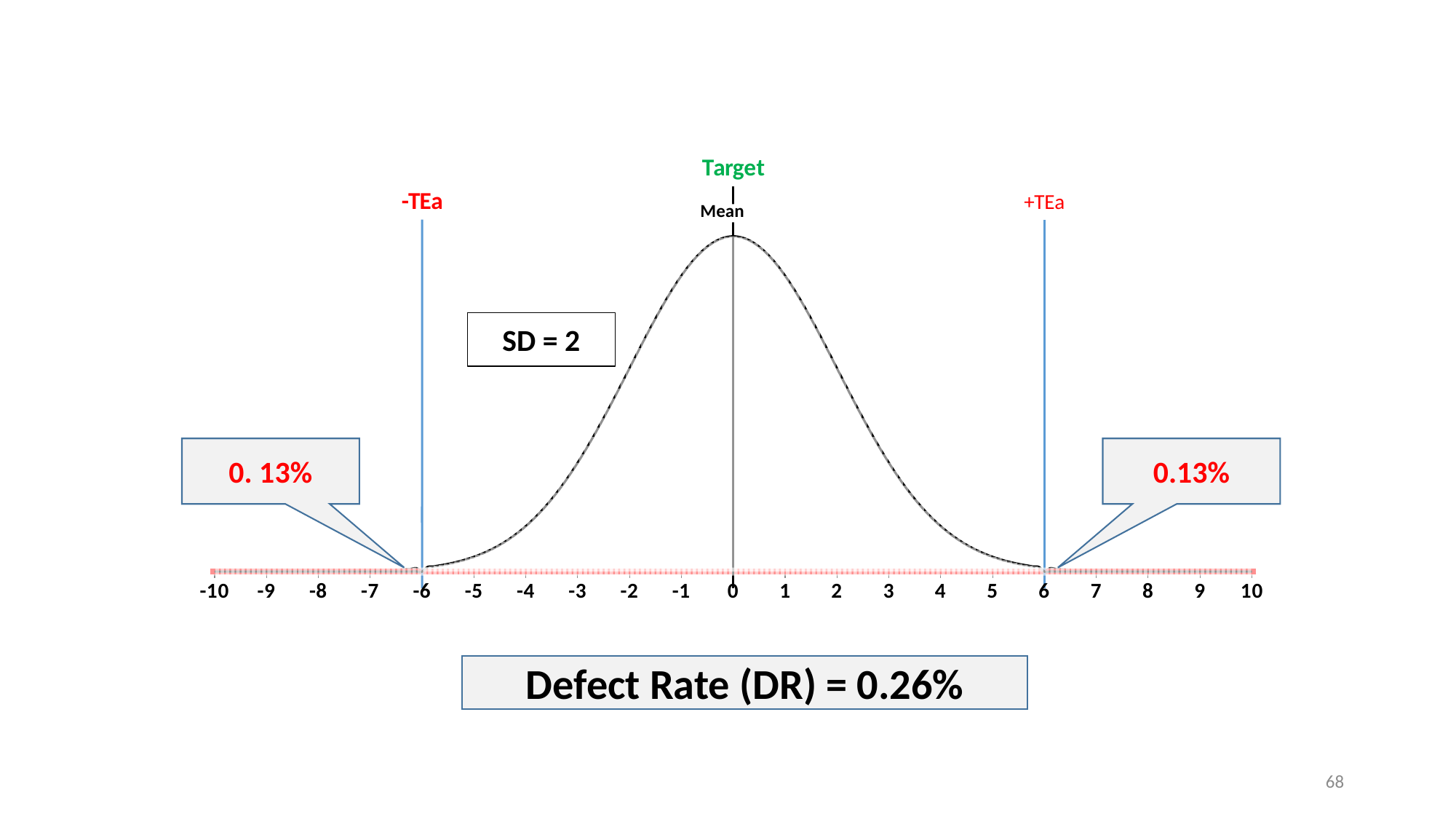
What is the combined percentage of the two tail callouts (0.13% and 0.13%)? 0.26% At which x-axis value is the -TEa line drawn? -6 At which x-axis value is the Mean line drawn? 0 What percentage is shown in the callout at the +TEa tail of the curve? 0.13% What green label appears above the peak of the curve? Target What percentage is shown in the callout at the -TEa tail of the curve? 0.13% What is the value of SD shown in the box on the chart? 2 What kind of chart is shown on the slide? Line chart How many tick labels are shown on the x axis? 21 Does the curve rise or fall as x goes from 0 to 10? Fall At which x-axis value is the +TEa line drawn? 6 What is the Defect Rate (DR) shown below the chart? 0.26%